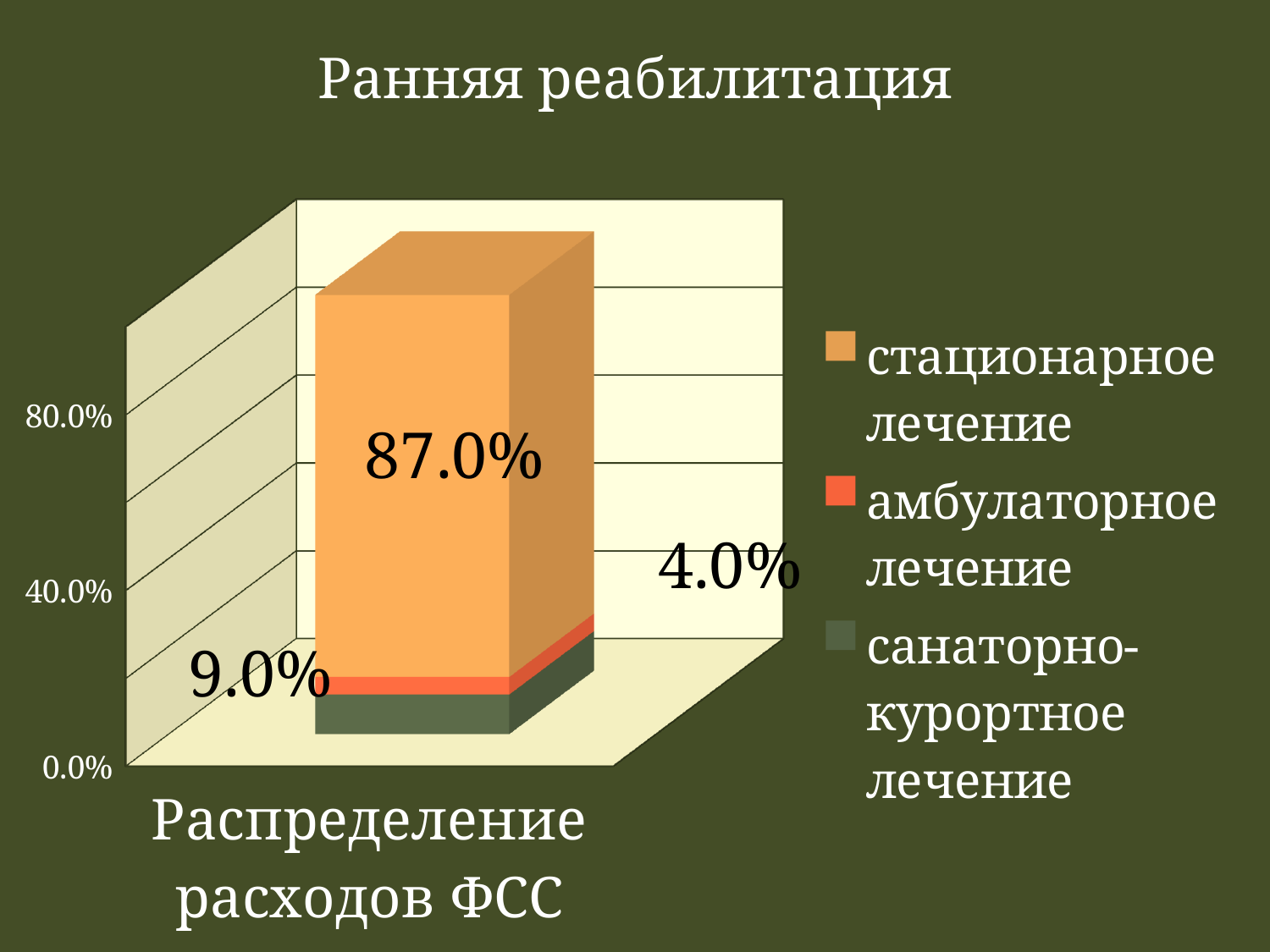
What is the total of the stacked bar for Распределение расходов ФСС? 100.0% What is the value for амбулаторное лечение? 4.0% What is the title of the slide? Ранняя реабилитация Which is larger, the value for санаторно-курортное лечение or амбулаторное лечение? санаторно-курортное лечение How many series does the legend list? 3 What kind of chart is shown on the slide? stacked bar chart Which series has the lowest value? амбулаторное лечение What is the value for стационарное лечение? 87.0% Is the value for стационарное лечение greater or less than 80.0%? greater Which series has the highest value? стационарное лечение What is the difference between the values for стационарное лечение and санаторно-курортное лечение? 78.0% What is the value for санаторно-курортное лечение? 9.0%